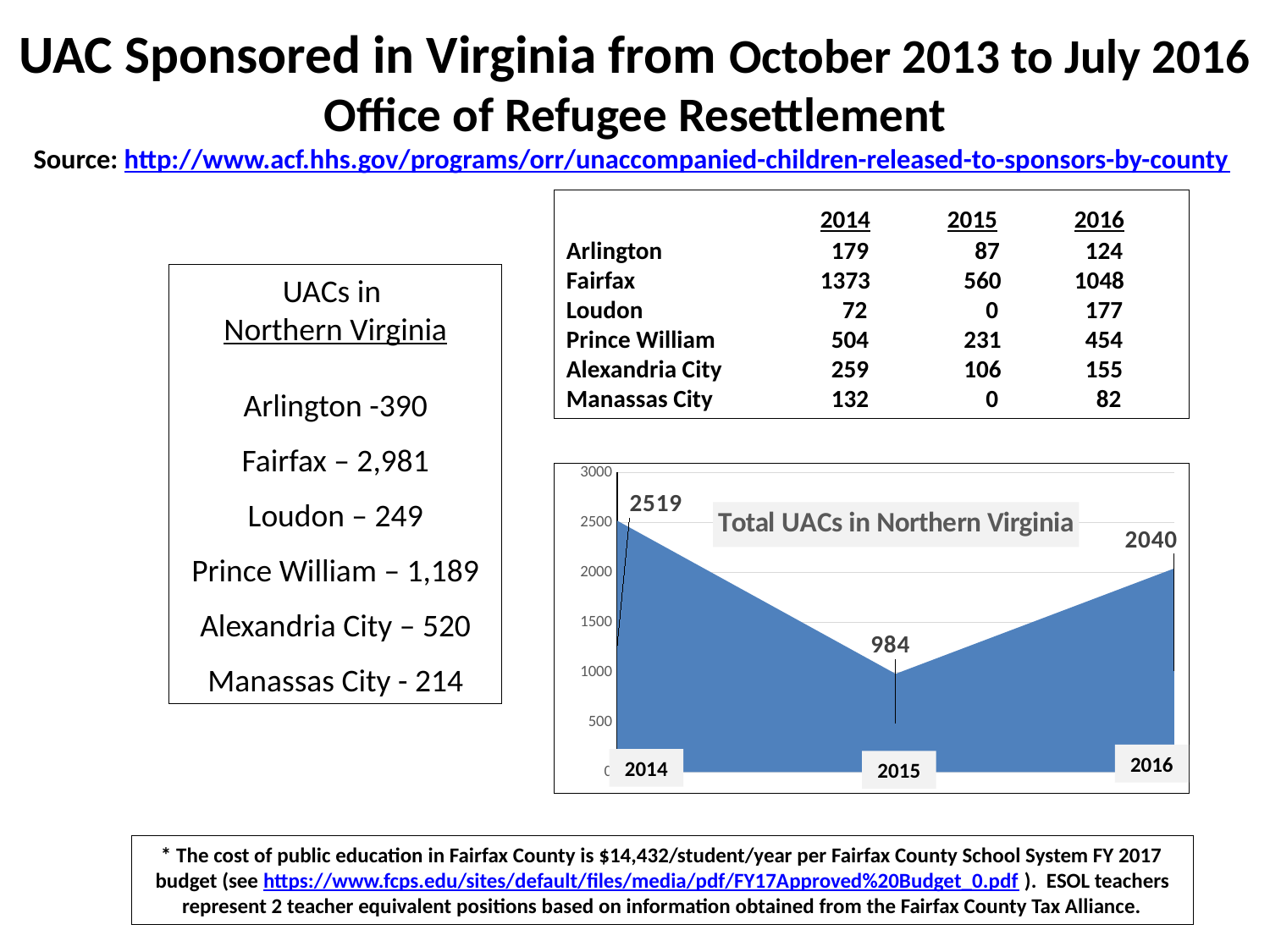
What is the value for 2016 in the Total UACs in Northern Virginia chart? 2040 What is the title of the chart on the slide? Total UACs in Northern Virginia How many years are plotted in the Total UACs in Northern Virginia chart? 3 Which is larger in the Total UACs in Northern Virginia chart, the value for 2014 or the value for 2016? 2014 Is the value for 2015 in the Total UACs in Northern Virginia chart greater or less than 1000? less What is the value for 2014 in the Total UACs in Northern Virginia chart? 2519 What is the difference between the 2016 and 2015 values in the Total UACs in Northern Virginia chart? 1056 What is the difference between the 2014 and 2015 values in the Total UACs in Northern Virginia chart? 1535 Which year has the lowest value in the Total UACs in Northern Virginia chart? 2015 What type of chart is shown on the slide? area chart Which year has the highest value in the Total UACs in Northern Virginia chart? 2014 What is the value for 2015 in the Total UACs in Northern Virginia chart? 984